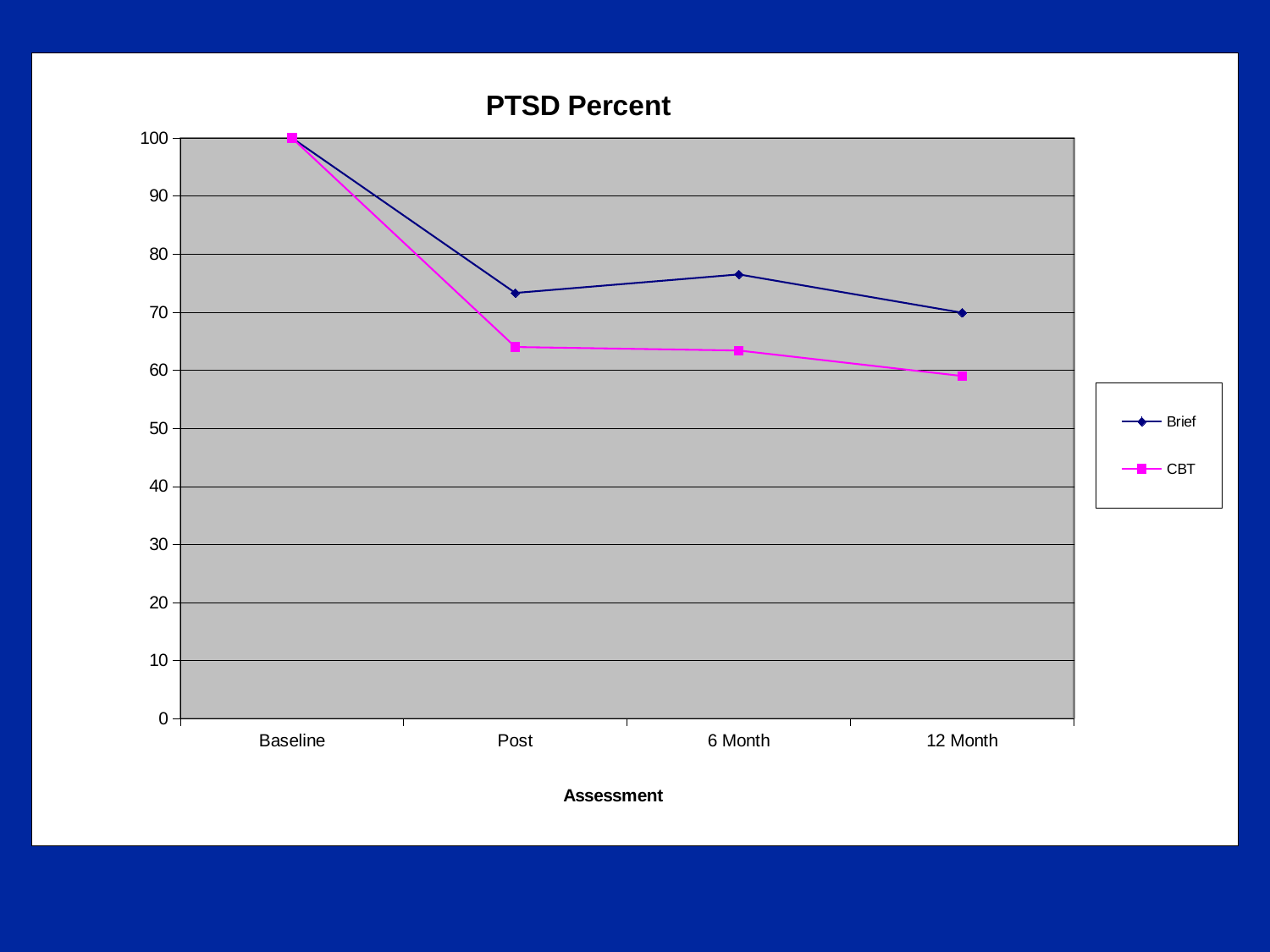
At which assessment point is the CBT value lowest? 12 Month Do the CBT values rise or fall from Baseline to 12 Month? fall At 12 Month, which series has the larger value, Brief or CBT? Brief Is the value for CBT at Post greater or less than 70? less How many series does the legend list? 2 What kind of chart is shown on the slide? line chart What is the title of the chart? PTSD Percent Is the value for Brief at Post greater or less than 70? greater How many assessment points are plotted along the x axis? 4 Is the value for Brief at 6 Month greater or less than 80? less What is the value for Brief at Baseline? 100